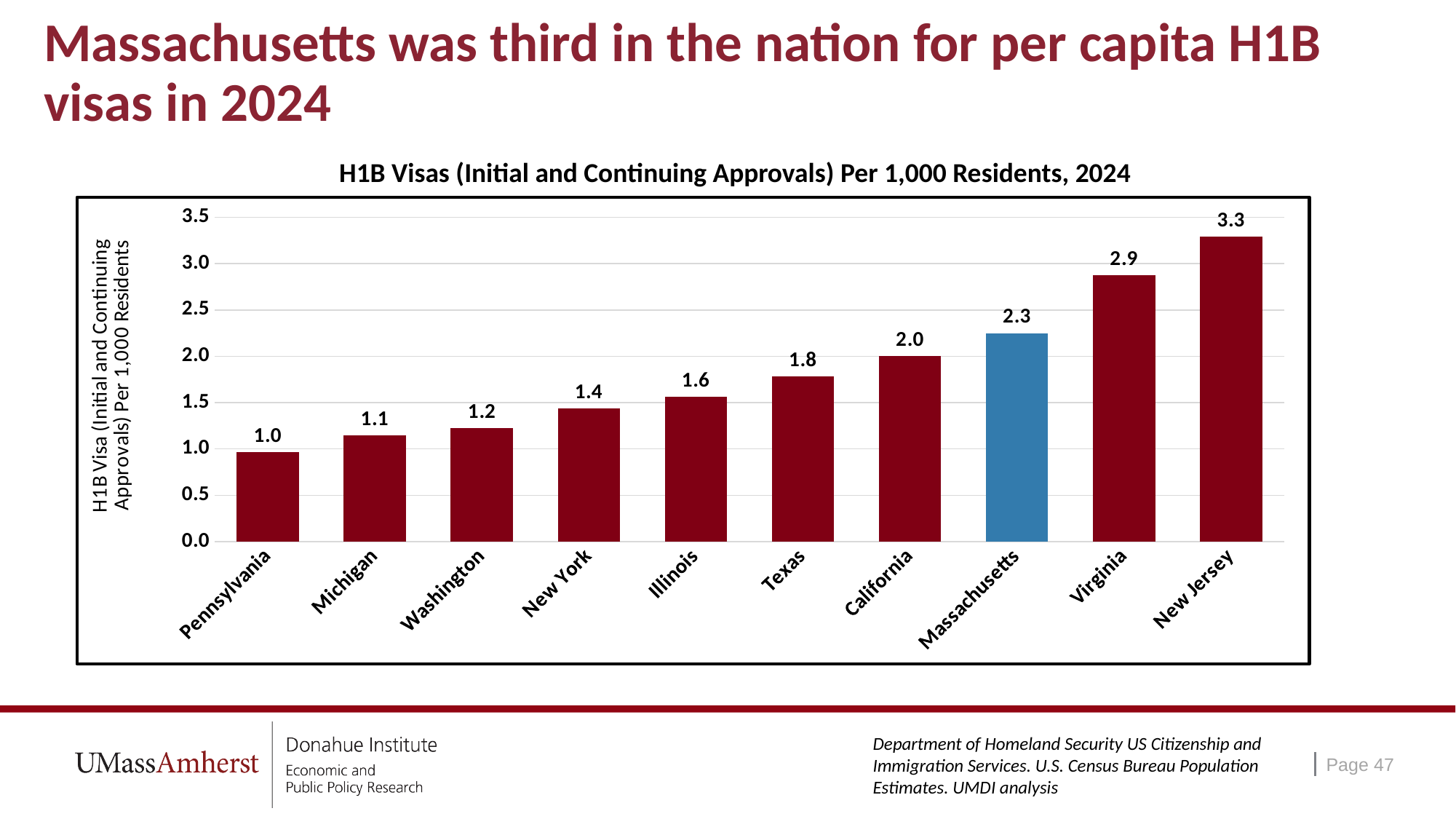
Which state has the highest value? New Jersey Which state has the lowest value? Pennsylvania What kind of chart is this? bar chart What is the value for Texas? 1.8 What is the value for Pennsylvania? 1.0 Do the values rise or fall from left to right along the x axis? rise What is the difference between the values for New Jersey and Massachusetts? 1.0 Which is larger, the value for Virginia or the value for California? Virginia Is the value for Illinois greater or less than 1.5? greater How many states are shown in the chart? 10 What is the value for Massachusetts? 2.3 Which state's bar is coloured blue instead of dark red? Massachusetts